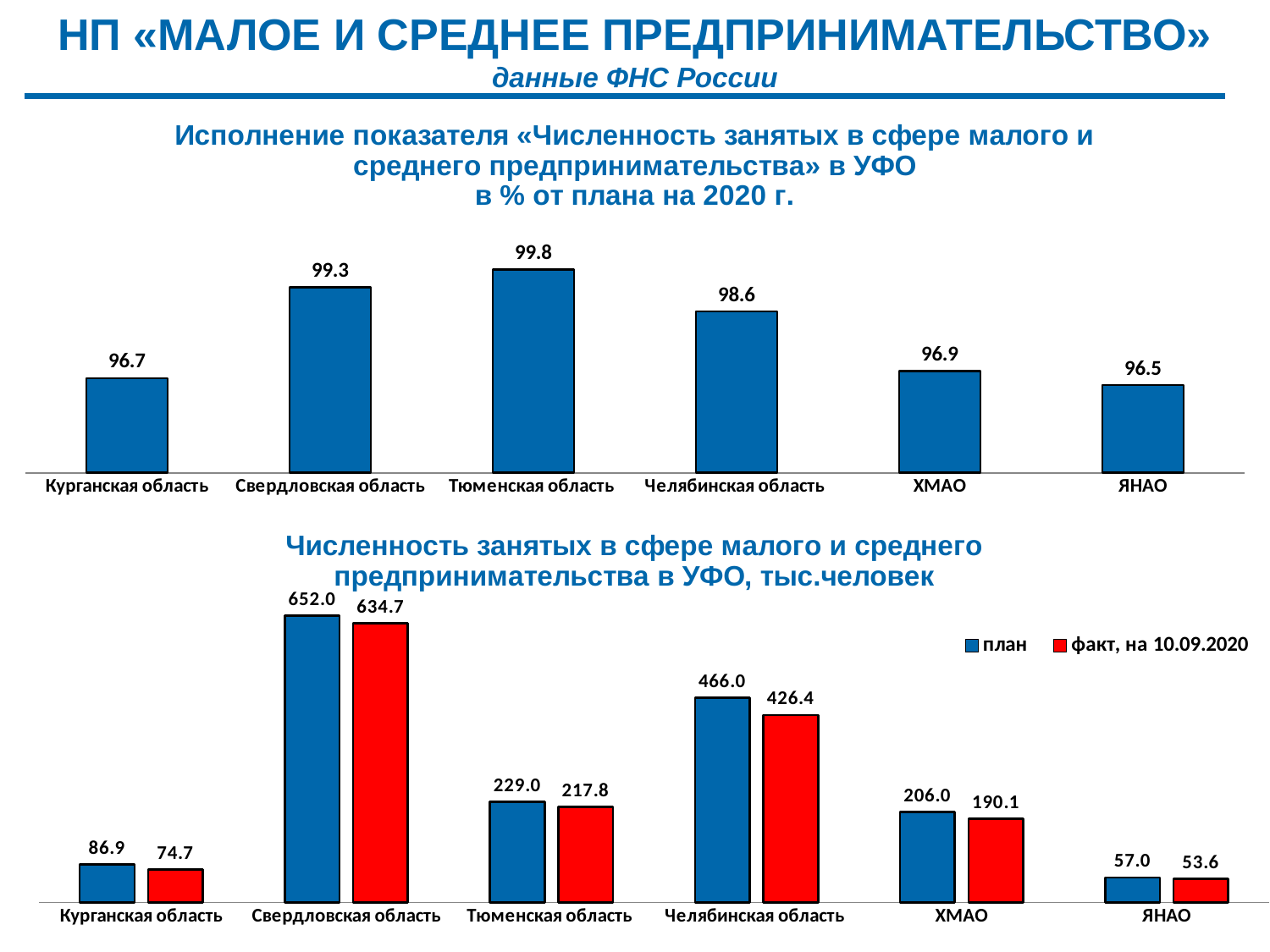
In the top chart (Исполнение показателя ... в % от плана на 2020 г.), what is the difference between Свердловская область and Курганская область? 2.6 In the top chart (Исполнение показателя ... в % от плана на 2020 г.), how many regions are shown? 6 What type of chart is the bottom chart (Численность занятых ... тыс.человек)? Bar chart In the bottom chart (Численность занятых ... тыс.человек), what is the план value for Челябинская область? 466.0 In the top chart (Исполнение показателя ... в % от плана на 2020 г.), which region has the lowest value? ЯНАО In the top chart (Исполнение показателя ... в % от плана на 2020 г.), what is the value for Тюменская область? 99.8 In the top chart (Исполнение показателя ... в % от плана на 2020 г.), which region has the highest value? Тюменская область In the bottom chart (Численность занятых ... тыс.человек), what is the difference between план and факт for Свердловская область? 17.3 In the bottom chart (Численность занятых ... тыс.человек), which region has the highest план value? Свердловская область In the bottom chart (Численность занятых ... тыс.человек), which is larger for Тюменская область: план or факт? план In the bottom chart (Численность занятых ... тыс.человек), how many series does the legend list? 2 In the bottom chart (Численность занятых ... тыс.человек), what is the факт value for ХМАО? 190.1